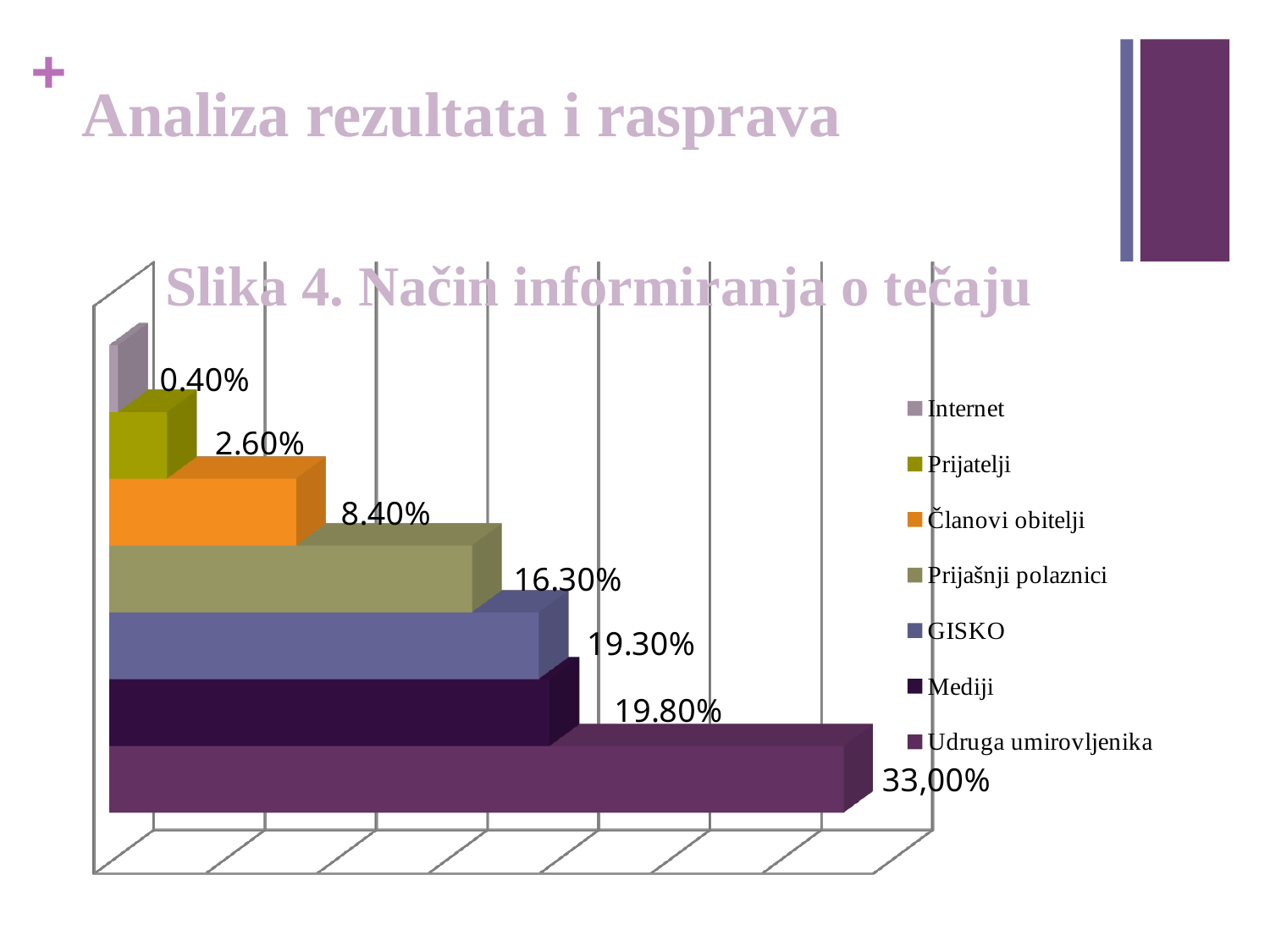
What is the value for Članovi obitelji? 8.40% Which category has the lowest value? Internet What is the value for Internet? 0.40% What is the value for Prijašnji polaznici? 16.30% What kind of chart is shown on the slide? Bar chart What is the value for Prijatelji? 2.60% What is the difference between the values for Mediji and GISKO? 0.50% What is the difference between the values for Prijašnji polaznici and Članovi obitelji? 7.90% How many categories are shown in the chart? 7 Which is larger, the value for Mediji or the value for GISKO? Mediji What is the value for Udruga umirovljenika? 33,00% Which category has the highest value? Udruga umirovljenika